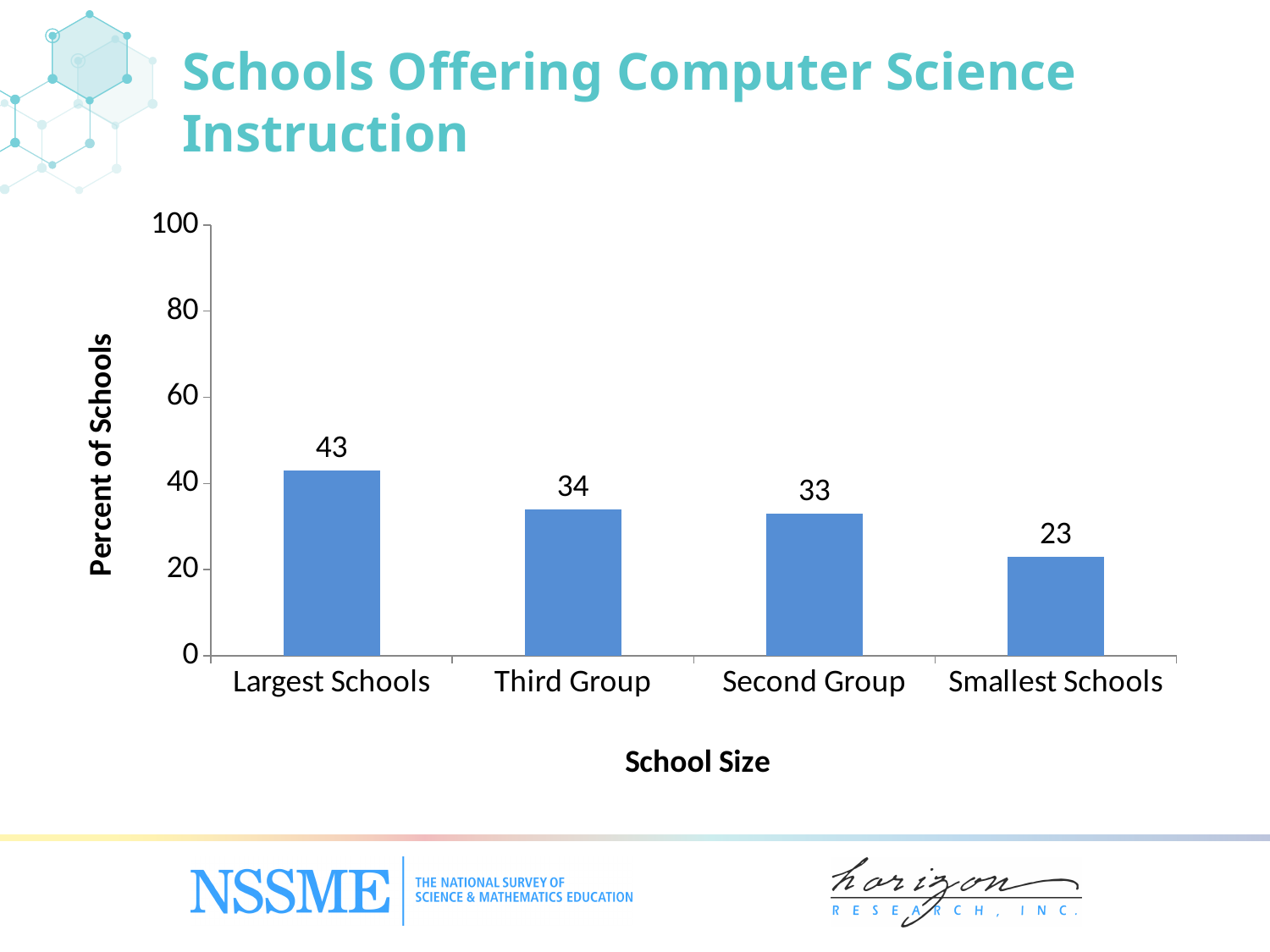
Which is larger, the value for Largest Schools or the value for Second Group? Largest Schools What is the value for the Third Group? 34 What is the difference between the values for Third Group and Second Group? 1 What is the label of the vertical axis? Percent of Schools What is the value for Smallest Schools? 23 What is the difference between the values for Largest Schools and Smallest Schools? 20 How many school size categories are shown on the chart? 4 What kind of chart is shown on the slide? Bar chart What percent of the Largest Schools offer computer science instruction? 43 Which school size category has the lowest value? Smallest Schools Which school size category has the highest percent of schools offering computer science instruction? Largest Schools Is the value for Smallest Schools greater or less than 40? less